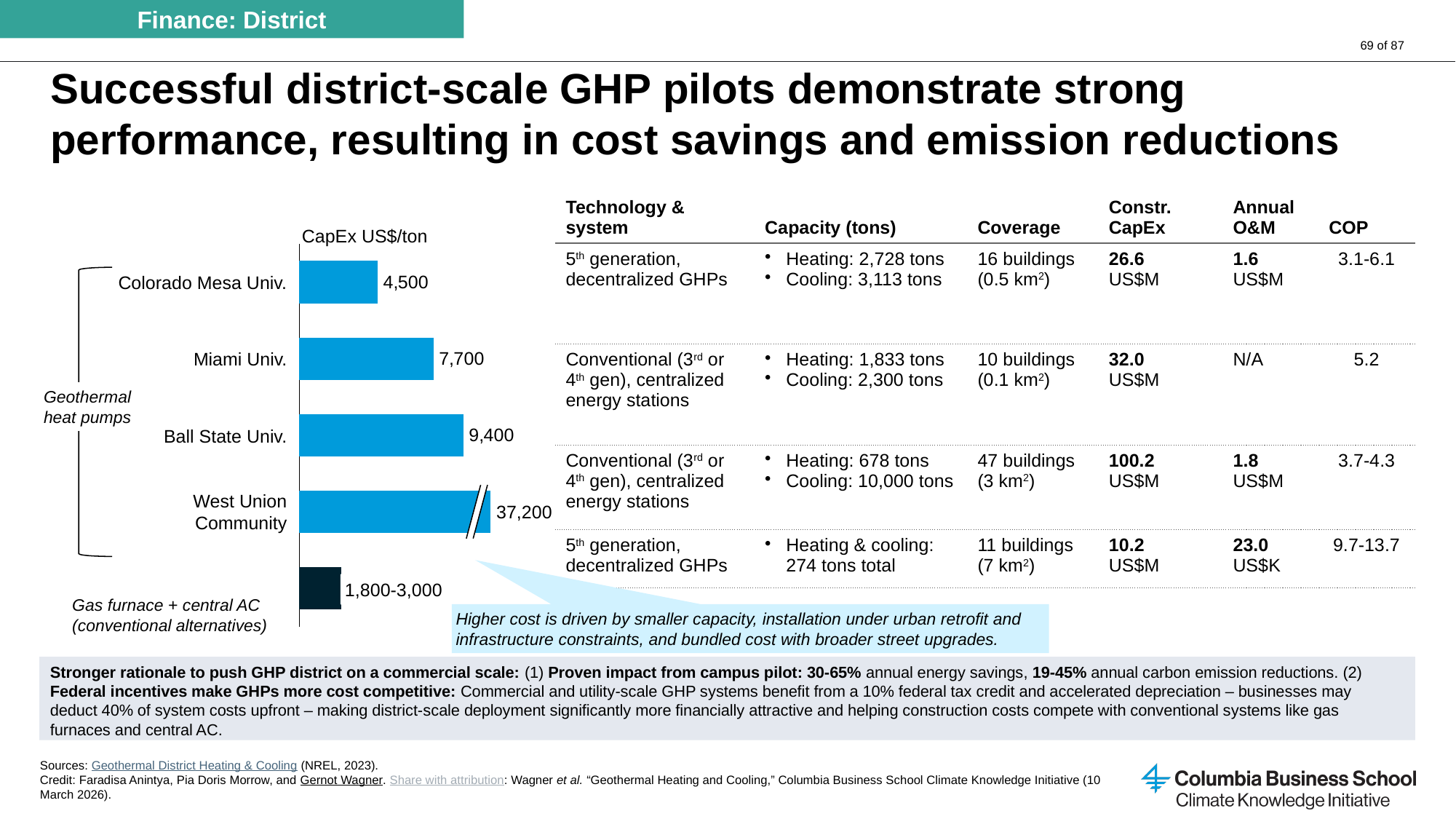
What is the CapEx US$/ton value for Miami Univ.? 7,700 What is the CapEx US$/ton value for Ball State Univ.? 9,400 How many bars are shown in the CapEx US$/ton chart? 5 What is the difference in CapEx US$/ton between Ball State Univ. and Miami Univ.? 1,700 What CapEx US$/ton range is shown for Gas furnace + central AC (conventional alternatives)? 1,800-3,000 What type of chart is used to show CapEx US$/ton? Bar chart What is the CapEx US$/ton value for Colorado Mesa Univ.? 4,500 Which has a higher CapEx US$/ton, Miami Univ. or Colorado Mesa Univ.? Miami Univ. What is the CapEx US$/ton value for West Union Community? 37,200 What is the difference in CapEx US$/ton between West Union Community and Colorado Mesa Univ.? 32,700 Which geothermal heat pump project has the lowest CapEx US$/ton? Colorado Mesa Univ. Which geothermal heat pump project has the highest CapEx US$/ton? West Union Community